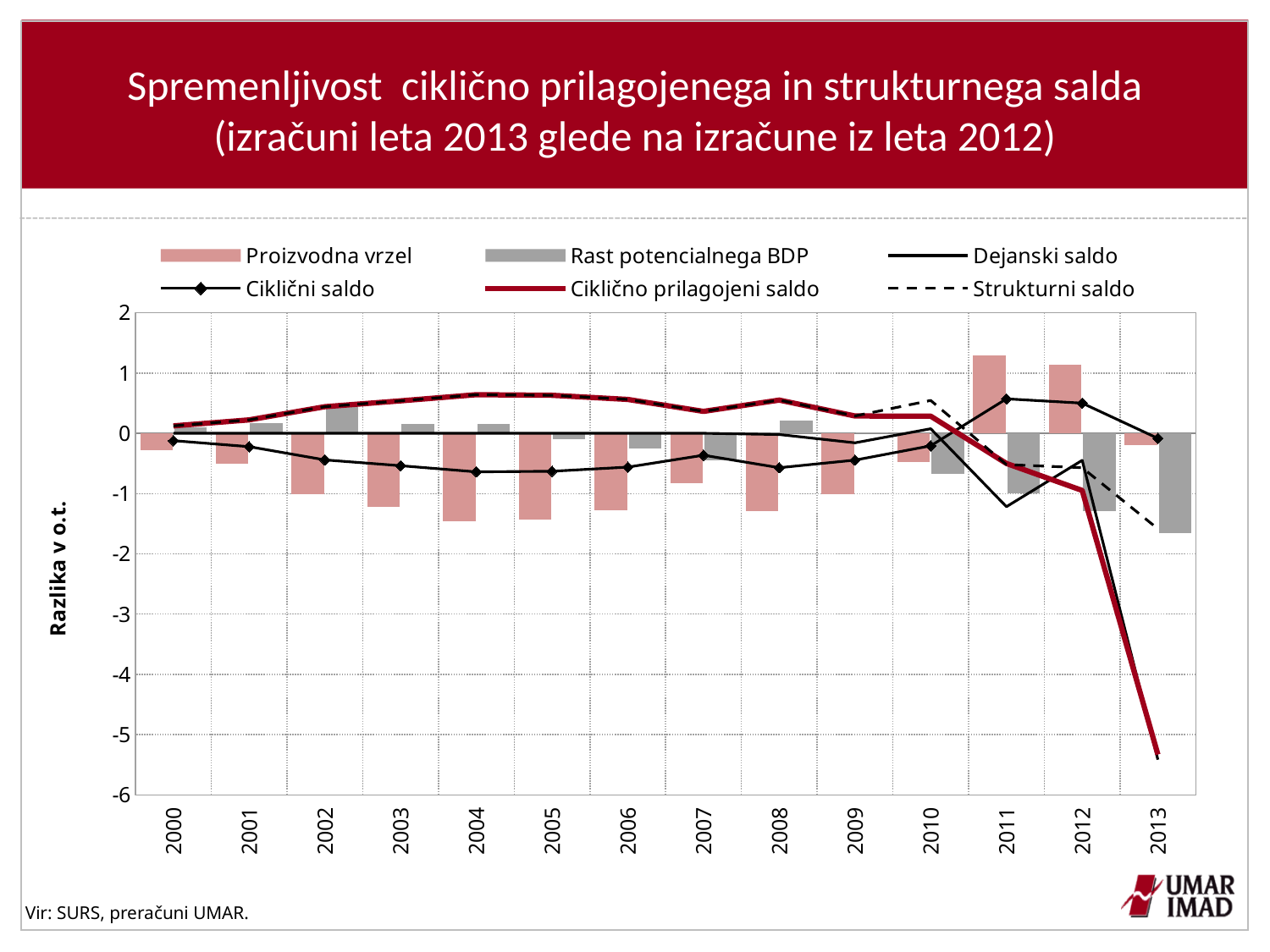
In which year does Ciklično prilagojeni saldo reach its lowest value? 2013 What is the label of the vertical axis of the chart? Razlika v o.t. What kind of chart is shown on the slide? Combined bar and line chart How many years are shown on the x axis of the chart? 14 Is the value of Ciklično prilagojeni saldo in 2013 greater or less than -5? less How many series does the chart legend list? 6 Does Ciklično prilagojeni saldo rise or fall from 2010 to 2013? fall In which year is Rast potencialnega BDP at its lowest? 2013 Is the value of Proizvodna vrzel in 2004 greater or less than -1? less Is the value of Rast potencialnega BDP in 2013 greater or less than -1? less Which is larger, Rast potencialnega BDP in 2011 or in 2013? 2011